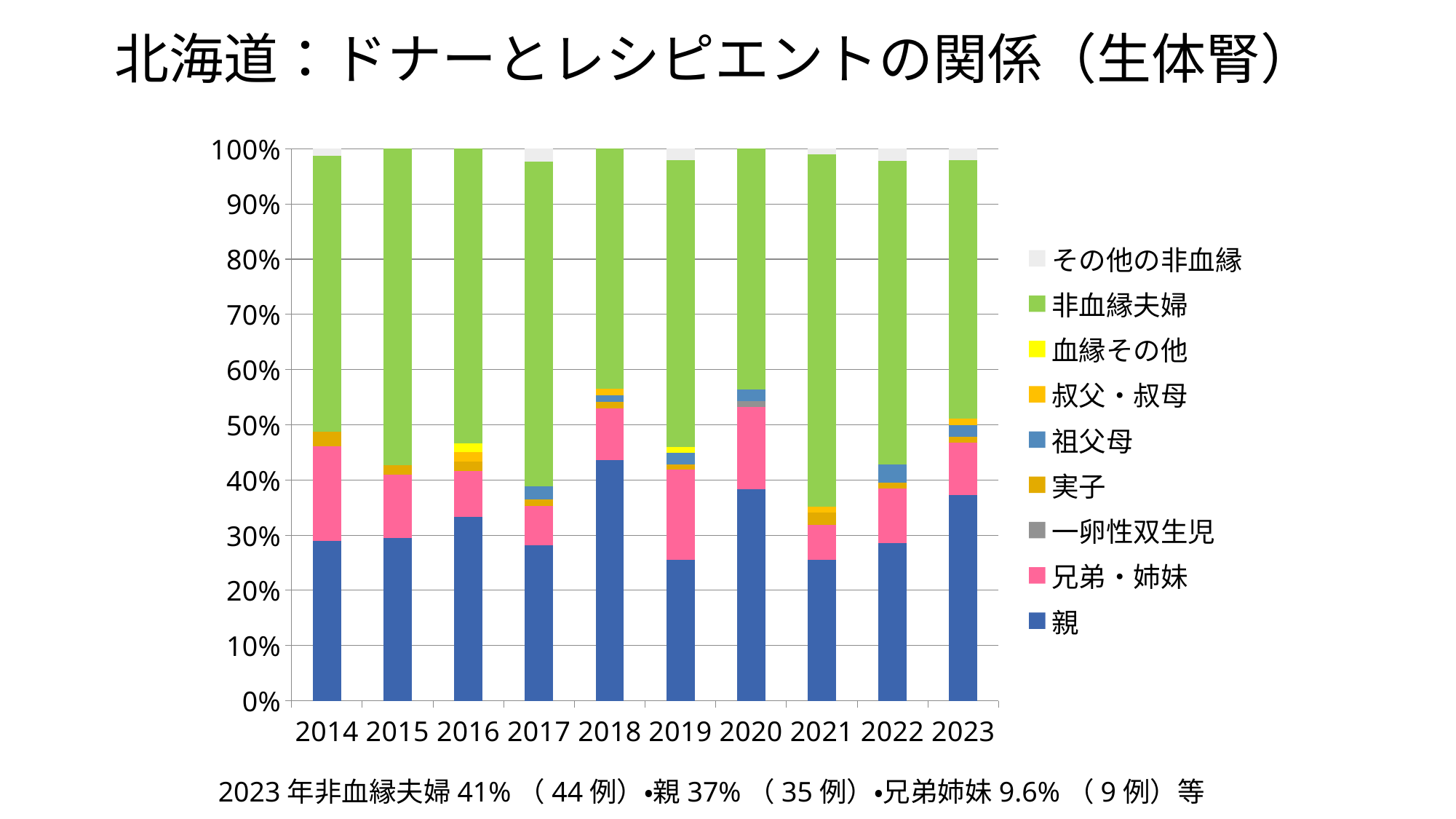
How many years are shown along the x axis of the chart? 10 According to the slide, what share did 親 account for in 2023? 37% In 2023, how many percentage points larger is the 非血縁夫婦 share than the 親 share? 4 According to the slide, how many cases (例) of 兄弟姉妹 donors were there in 2023? 9 例 According to the slide, what share did 非血縁夫婦 account for in 2023? 41% Which legend entry is shown in blue at the bottom of each bar? 親 Is the 親 share in 2018 greater or less than 40%? greater In which year is the 親 share of the bar the highest? 2018 What kind of chart is shown on the slide? Stacked bar chart How many series does the chart's legend list? 9 Is the 親 share in 2019 greater or less than 30%? less Which year has the larger 親 share, 2017 or 2018? 2018